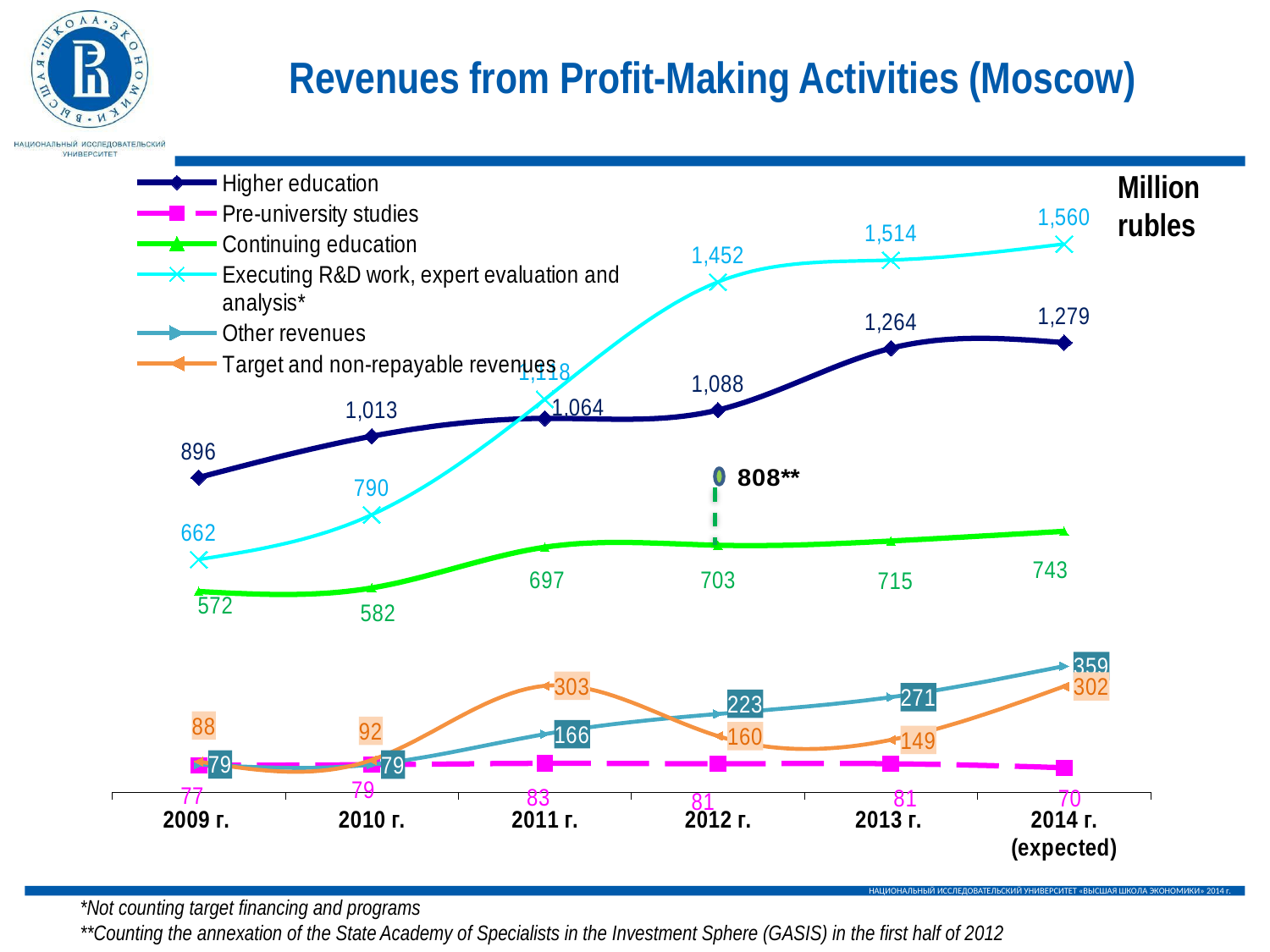
By how much did Higher education revenue grow from 2009 to 2014 (expected)? 383 In which year is Continuing education highest? 2014 (expected) What kind of chart is shown on the slide? Line chart Does the Executing R&D work, expert evaluation and analysis series rise or fall from 2009 to 2014 (expected)? Rise What is the value for Target and non-repayable revenues in 2011? 303 What is the value for Executing R&D work, expert evaluation and analysis in 2014 (expected)? 1,560 What is the value for Higher education in 2009? 896 In 2012, which is larger: Other revenues or Target and non-repayable revenues? Other revenues How many years are shown on the x axis? 6 In what units are the values on the chart expressed? Million rubles How many series does the legend list? 6 In which year is Pre-university studies lowest? 2014 (expected)